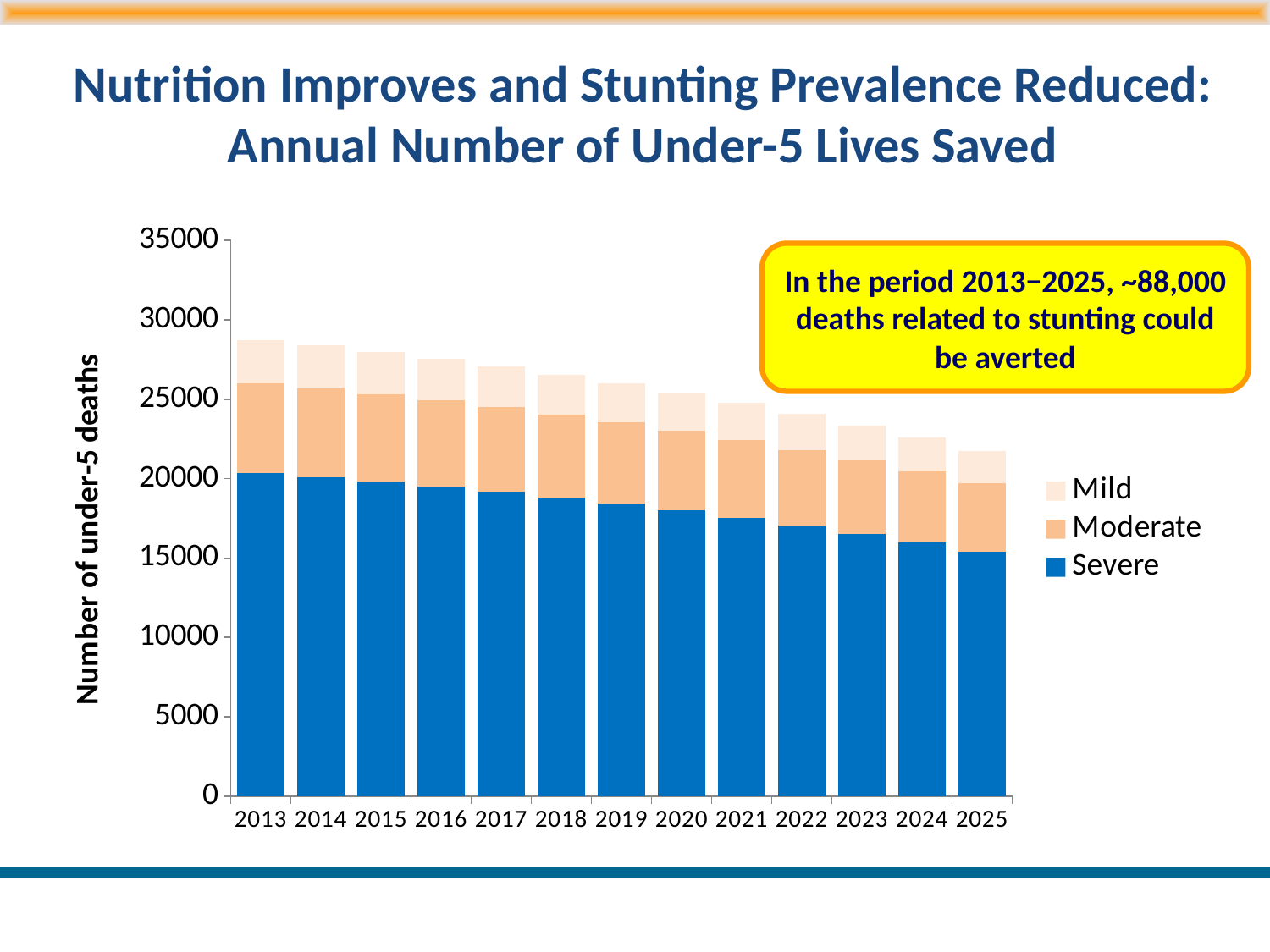
Is the Severe value for 2020 greater or less than 20000? less Which year has the shortest stacked bar? 2025 Do the total bar heights rise or fall from 2013 to 2025? Fall Which year has the larger Severe value, 2013 or 2025? 2013 How many series does the chart's legend list? 3 What is the label of the vertical axis? Number of under-5 deaths How many years are shown on the x axis of the chart? 13 Which series are listed in the chart's legend? Mild, Moderate, Severe Is the total stacked value for 2025 greater or less than 20000? greater Which year has the tallest stacked bar? 2013 Is the total stacked value for 2013 greater or less than 30000? less What kind of chart is shown on the slide? Stacked bar chart